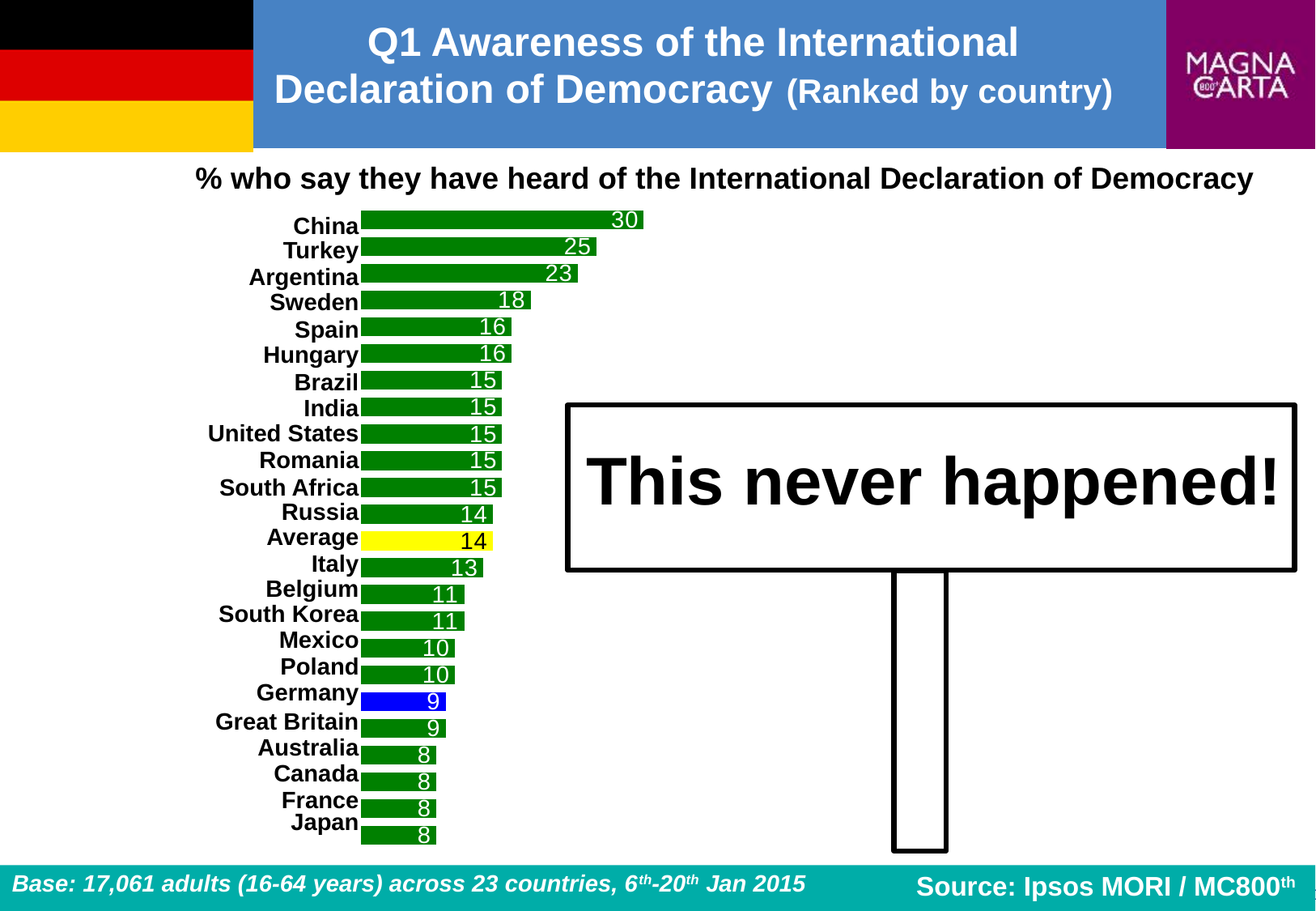
What is the value for China? 30 Which has a larger value, Argentina or Italy? Argentina How many bars are plotted in the chart, including the Average bar? 24 What kind of chart is shown on the slide? Bar chart Which country has the highest value? China What is the value shown for Average? 14 What is the value for Turkey? 25 What is the value for Germany? 9 Which bar is coloured blue? Germany What is the difference between the values for China and Turkey? 5 What is the difference between the values for Sweden and Japan? 10 Which has a larger value, Russia or Belgium? Russia